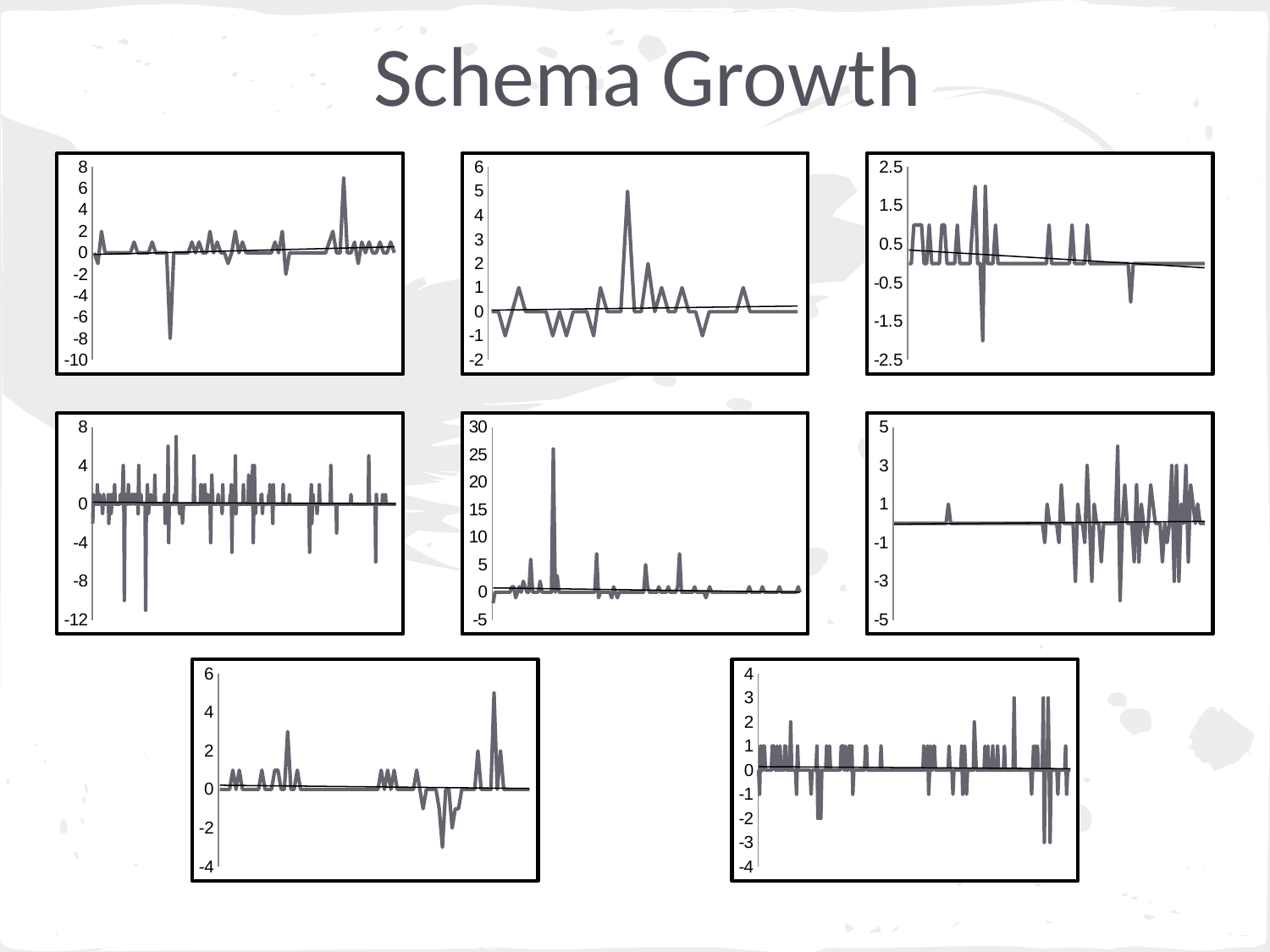
What kind of chart is the top-left chart? line chart In the left chart of the second row, is the lowest dip of the line greater or less than -8? less In the top-middle chart, is the highest peak of the line greater or less than 4? greater What is the lowest value shown on the y axis of the left chart in the second row? -12 In the bottom-left chart, is the highest peak of the line greater or less than 4? greater In the top-left chart, does the straight trend line rise or fall from left to right? rise In the top-right chart, does the straight trend line rise or fall from left to right? fall How many charts are shown on the slide? 8 What is the highest value shown on the y axis of the top-right chart? 2.5